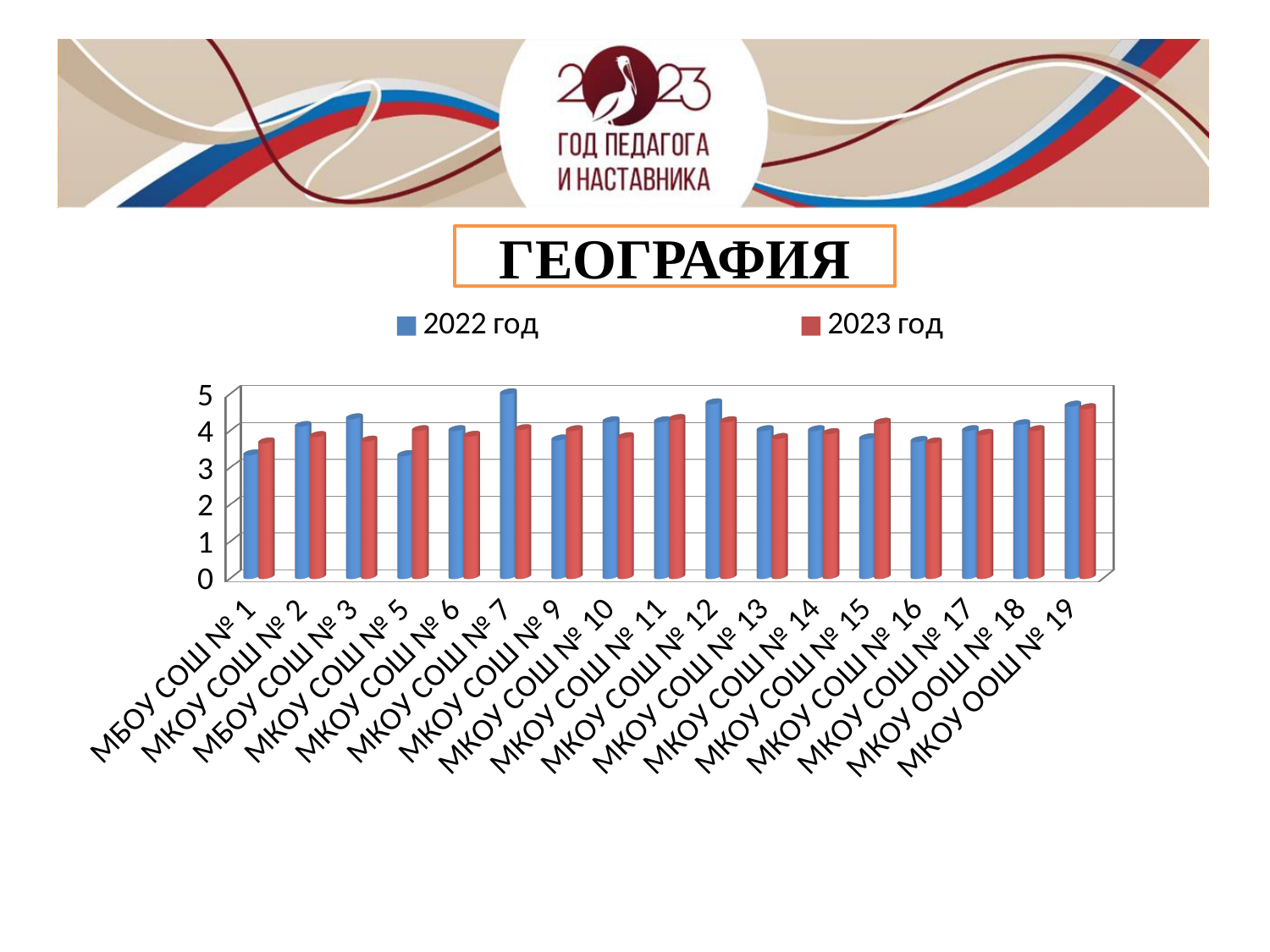
How many schools (categories) are shown on the x axis? 17 Is the 2022 год value for МКОУ СОШ № 7 greater or less than 4? greater For МБОУ СОШ № 1, which year has the larger value, 2022 год or 2023 год? 2023 год For МКОУ СОШ № 5, which year has the larger value, 2022 год or 2023 год? 2023 год What are the two entries in the chart legend? 2022 год and 2023 год Is the 2022 год value for МБОУ СОШ № 1 greater or less than 4? less What kind of chart is shown on the slide? bar chart For МКОУ СОШ № 7, which year has the larger value, 2022 год or 2023 год? 2022 год How many series does the legend list? 2 Which school has the highest value for 2022 год? МКОУ СОШ № 7 Is the 2022 год value for МКОУ СОШ № 5 greater or less than 4? less